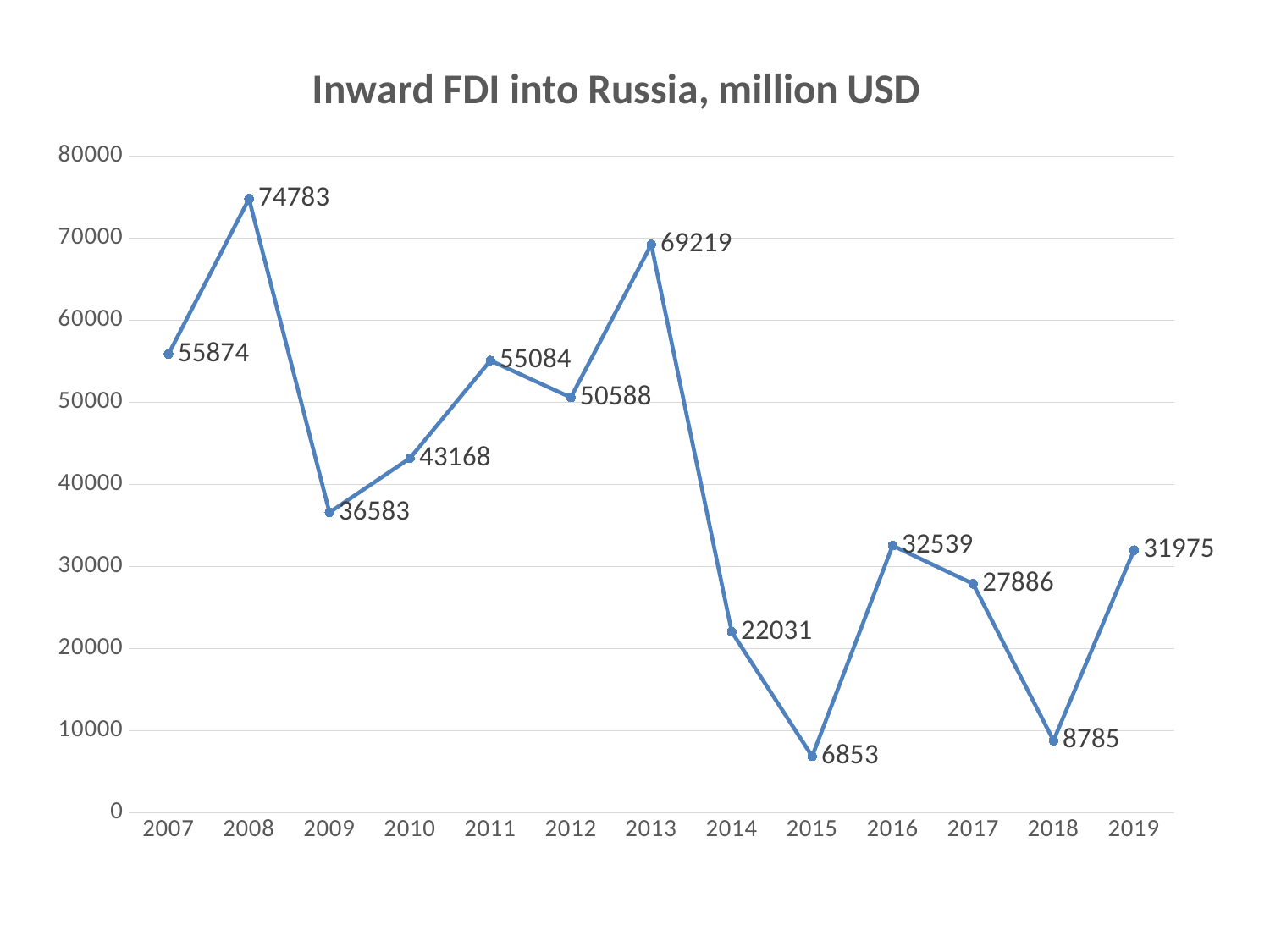
Which year has the lowest inward FDI into Russia? 2015 What is the inward FDI into Russia in 2015? 6853 Which year has a larger inward FDI value, 2011 or 2012? 2011 How many years are plotted on the chart? 13 Does the inward FDI rise or fall from 2013 to 2015? fall What is the title of the chart? Inward FDI into Russia, million USD Is the value for 2018 greater or less than 10000? less What is the inward FDI into Russia in 2008? 74783 Which year has the highest inward FDI into Russia? 2008 What is the difference between the inward FDI in 2013 and in 2014? 47188 What is the inward FDI into Russia in 2019? 31975 What kind of chart is shown on the slide? line chart